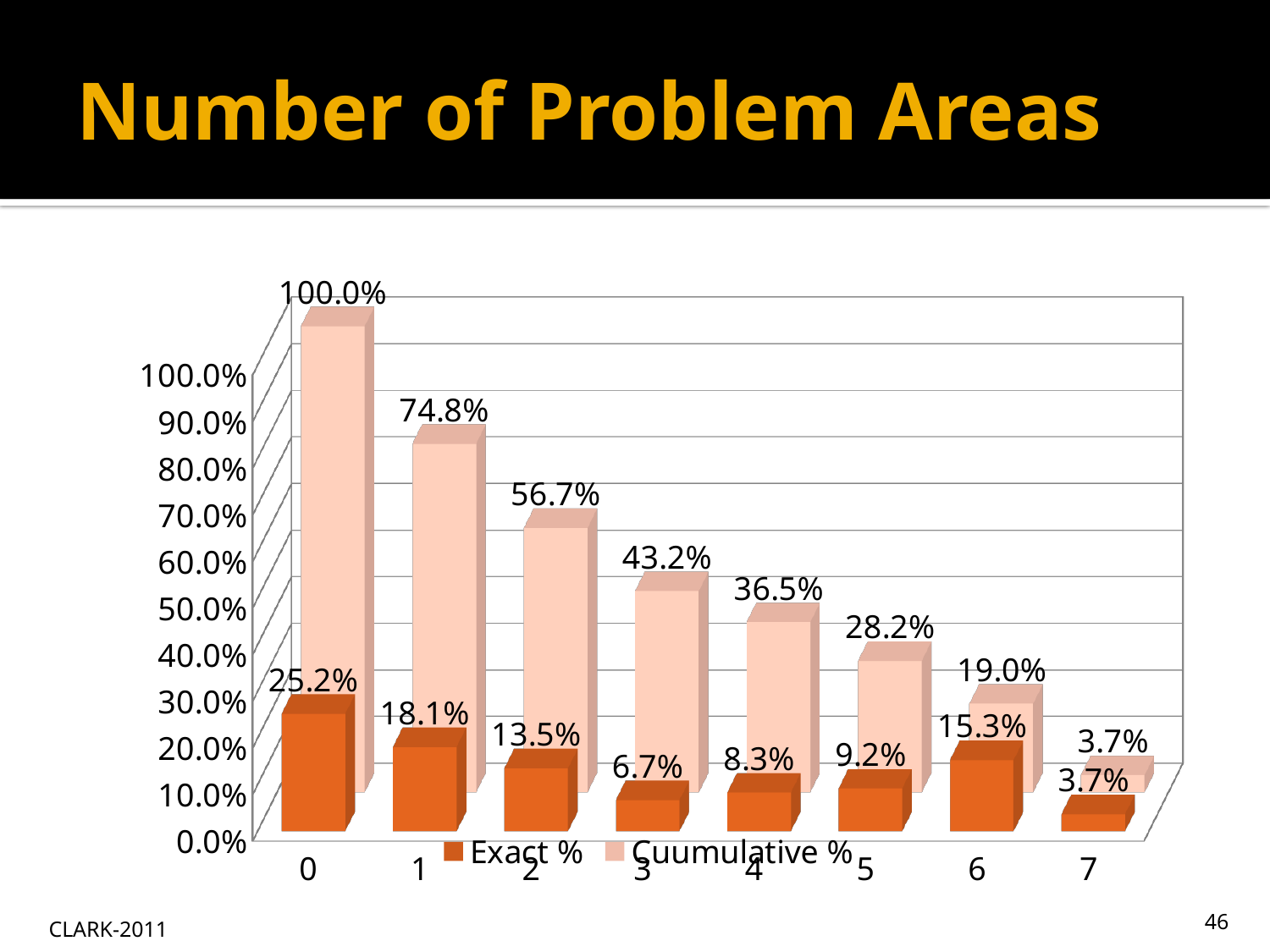
Which is larger, the Exact % value for category 4 or for category 5? category 5 What is the Cuumulative % value for category 3? 43.2% How many series does the legend list? 2 Is the Cuumulative % value for category 5 greater or less than 30.0%? less Do the Cuumulative % values rise or fall from category 0 to category 7? fall How many categories are shown on the x axis? 8 What is the difference between the Cuumulative % values for categories 1 and 2? 18.1% Which category has the lowest Exact % value? 7 What is the Exact % value for category 6? 15.3% What is the Exact % value for category 0? 25.2% What kind of chart is shown on the slide? bar chart Which category has the highest Exact % value? 0